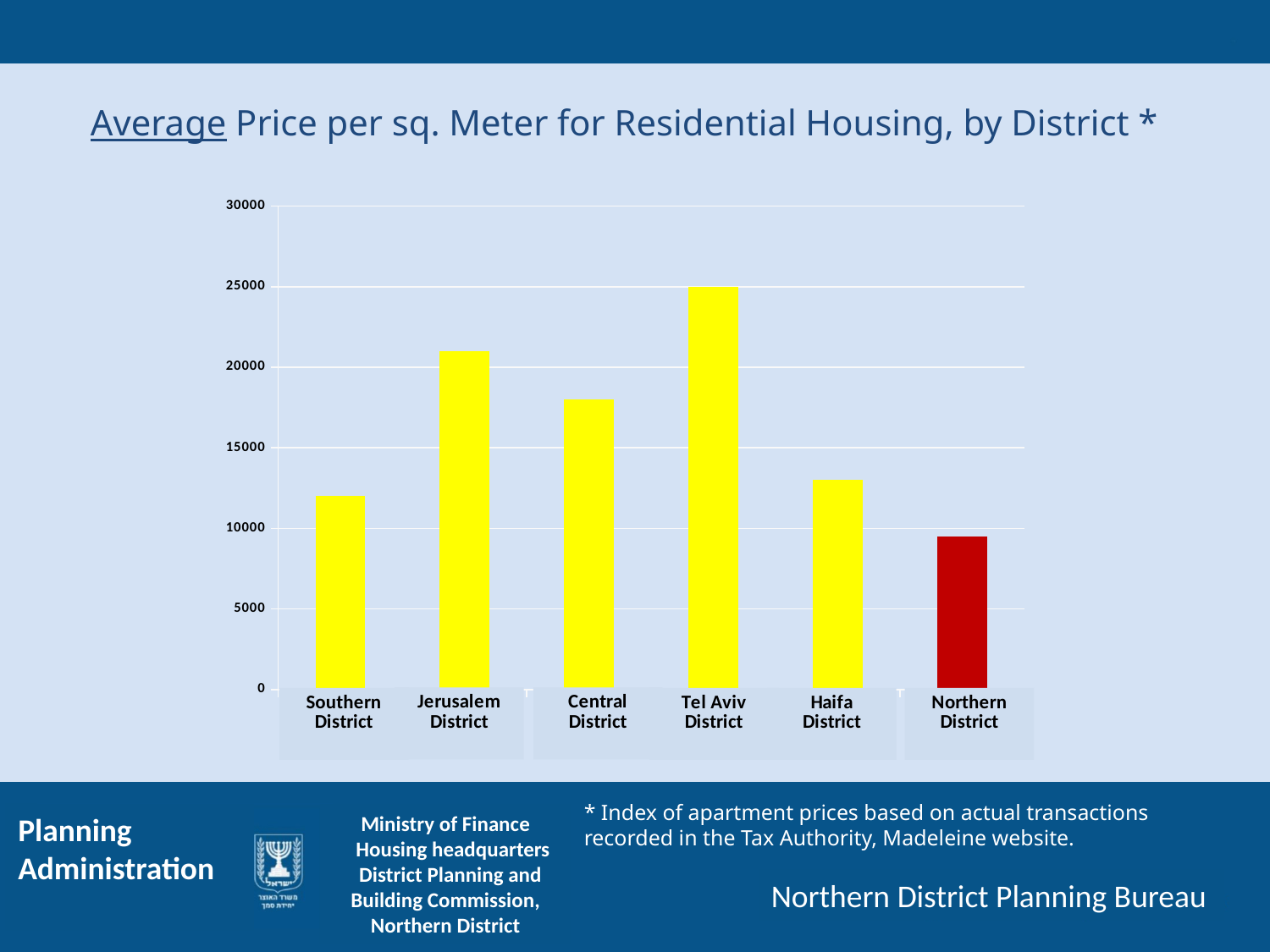
Is the value for Northern District greater or less than 10000? less How many districts are shown on the chart? 6 Is the value for Jerusalem District greater or less than 20000? greater Which district's bar is coloured red instead of yellow? Northern District Which has a higher average price per sq. meter, Haifa District or Southern District? Haifa District Which has a higher average price per sq. meter, Jerusalem District or Central District? Jerusalem District Which district has the highest average price per sq. meter? Tel Aviv District What kind of chart is shown on the slide? bar chart Is the value for Central District greater or less than 20000? less Which district has the lowest average price per sq. meter? Northern District What is the title of the chart? Average Price per sq. Meter for Residential Housing, by District *